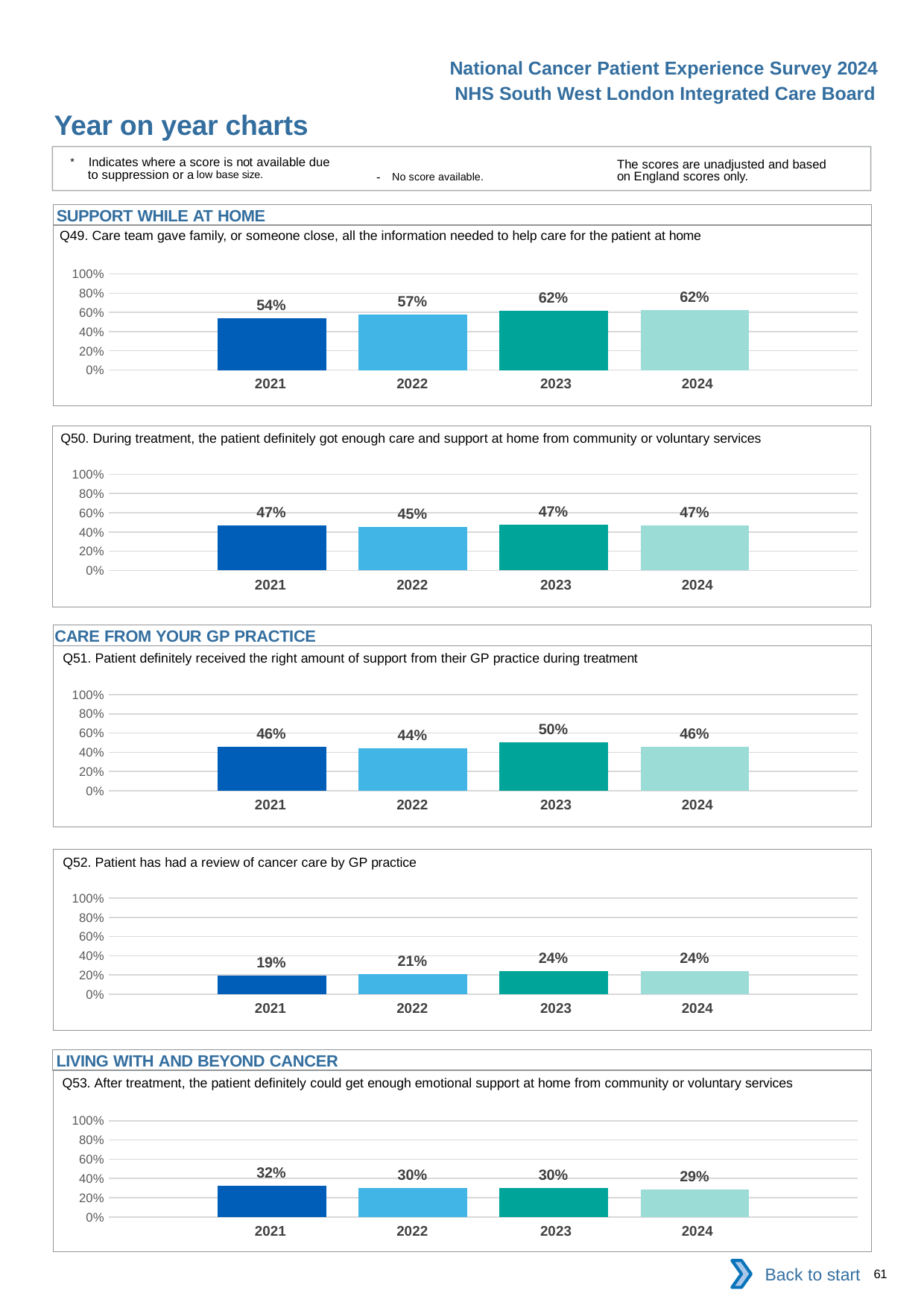
In the Q50 chart, which year has the lowest value? 2022 In the Q52 chart, what is the value for 2021? 19% In the Q49 chart, what is the value for 2021? 54% In the Q50 chart, what is the value for 2024? 47% In the Q49 chart, what is the difference between the 2024 value and the 2021 value? 8% In the Q52 chart, do the values generally rise or fall from 2021 to 2024? rise What type of chart is used for Q49? bar chart In the Q53 chart, is the value for 2021 greater or less than 40%? less How many years are shown on the x axis of the Q53 chart? 4 In the Q53 chart, what is the value for 2024? 29% In the Q51 chart, is the value for 2022 larger or smaller than the value for 2023? smaller In the Q51 chart, which year has the highest value? 2023